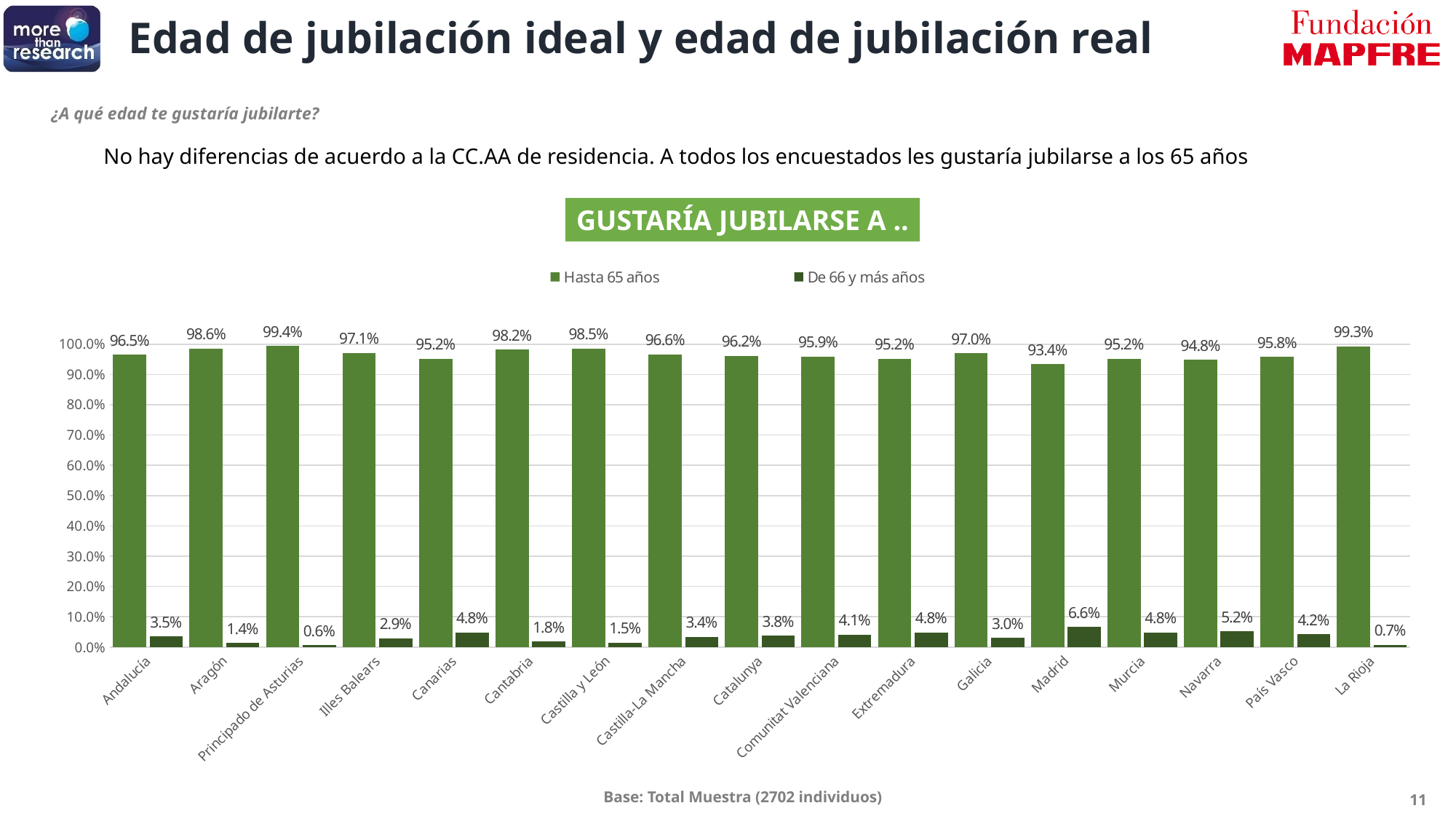
What is the 'Hasta 65 años' value for La Rioja? 99.3% What are the two series named in the chart legend? Hasta 65 años and De 66 y más años What kind of chart is shown on the slide? Bar chart What is the value for Madrid in the 'De 66 y más años' series? 6.6% What percentage of respondents in Andalucía would like to retire at up to 65 years (Hasta 65 años)? 96.5% How many series does the chart legend list? 2 Which has a higher 'Hasta 65 años' value, Canarias or Cantabria? Cantabria What is the difference between the 'De 66 y más años' values for Madrid and Aragón? 5.2 percentage points Which region has the lowest value in the 'Hasta 65 años' series? Madrid Which region has the highest value in the 'De 66 y más años' series? Madrid How many regions (categories) are shown on the x axis of the chart? 17 Is the 'Hasta 65 años' value for Madrid greater or less than 90.0%? greater